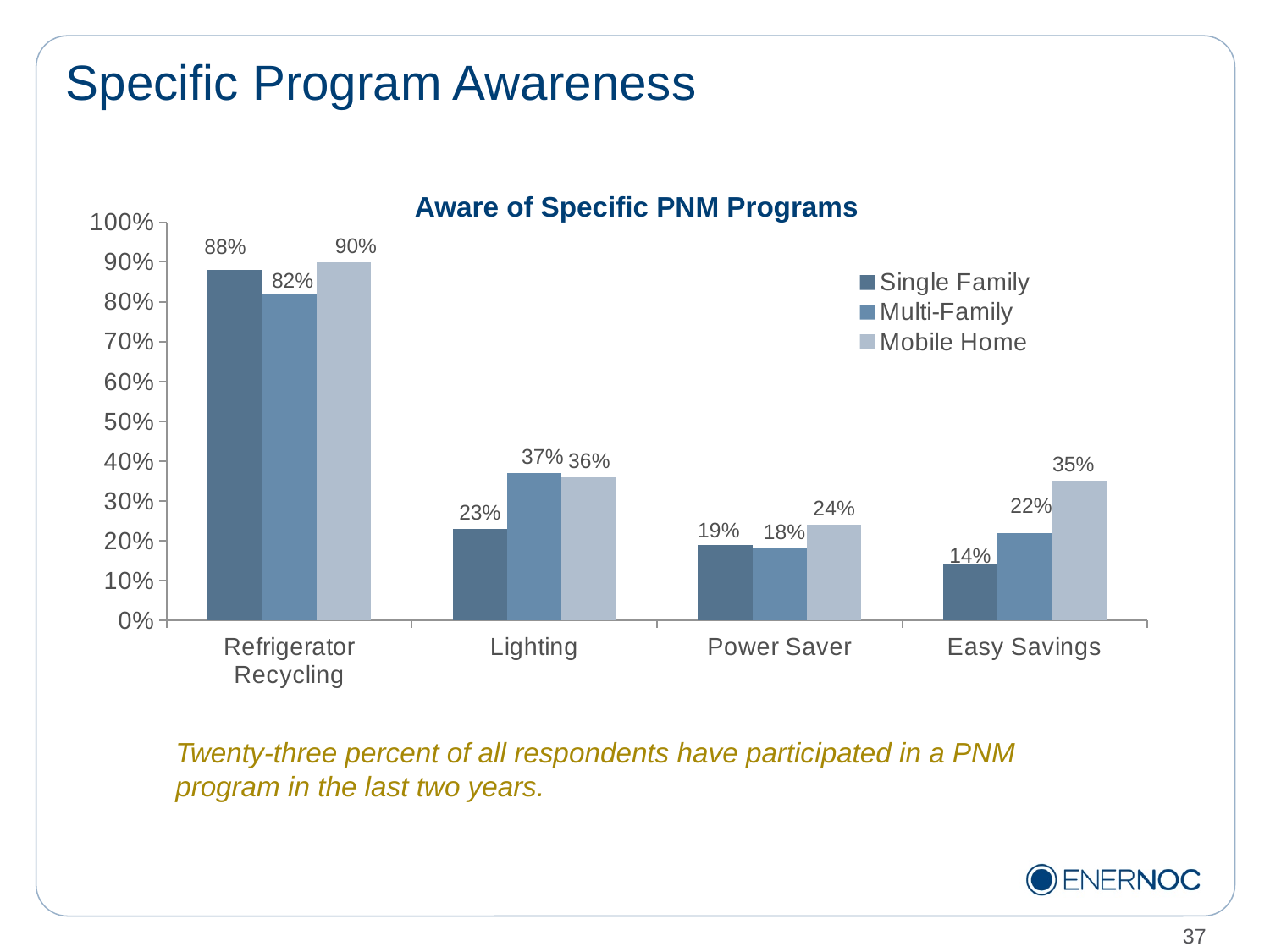
Which program has the highest Mobile Home awareness? Refrigerator Recycling What is the difference between the Mobile Home and Single Family values for Easy Savings? 21% How many programs are shown on the x axis? 4 Which is larger for Power Saver: the Single Family value or the Mobile Home value? Mobile Home How many series does the legend list? 3 Is the Multi-Family value for Refrigerator Recycling greater or less than 50%? greater What is the Single Family value for Refrigerator Recycling? 88% Which program has the lowest Single Family awareness? Easy Savings What is the Multi-Family value for Lighting? 37% What is the Mobile Home value for Easy Savings? 35% What kind of chart is shown on the slide? Bar chart What is the title of the chart? Aware of Specific PNM Programs